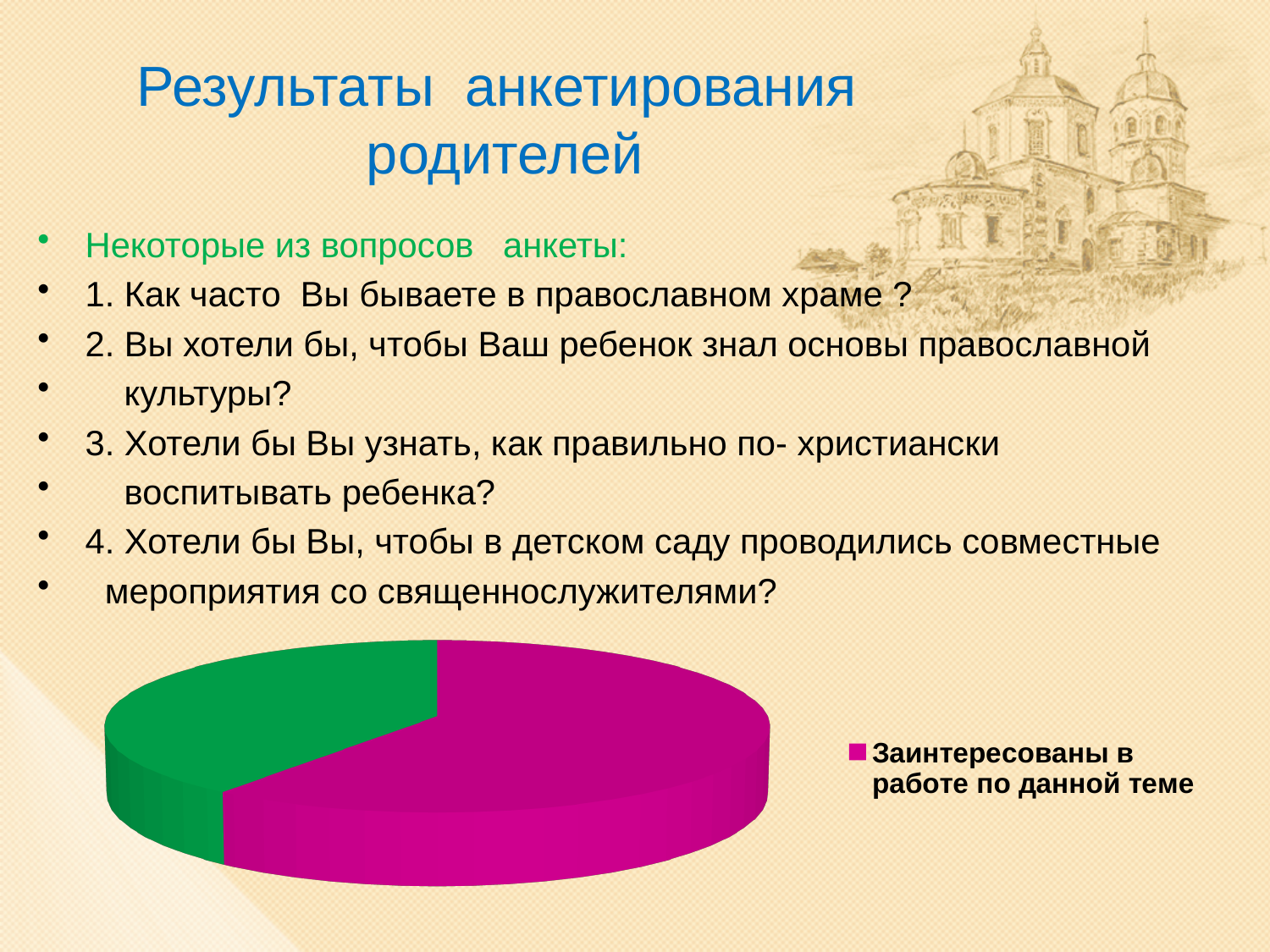
Is the slice "Заинтересованы в работе по данной теме" larger or smaller than the unlabelled green slice? larger How many entries does the legend of the pie chart list? 1 Which slice of the pie chart is the smallest? the green slice How many slices does the pie chart have? 2 Which slice of the pie chart is the largest? Заинтересованы в работе по данной теме What is the legend entry shown next to the pie chart? Заинтересованы в работе по данной теме Which slice of the pie chart is larger: the magenta slice or the green slice? the magenta slice What kind of chart is shown on the slide? pie chart What colour is the slice labelled "Заинтересованы в работе по данной теме" in the pie chart? magenta